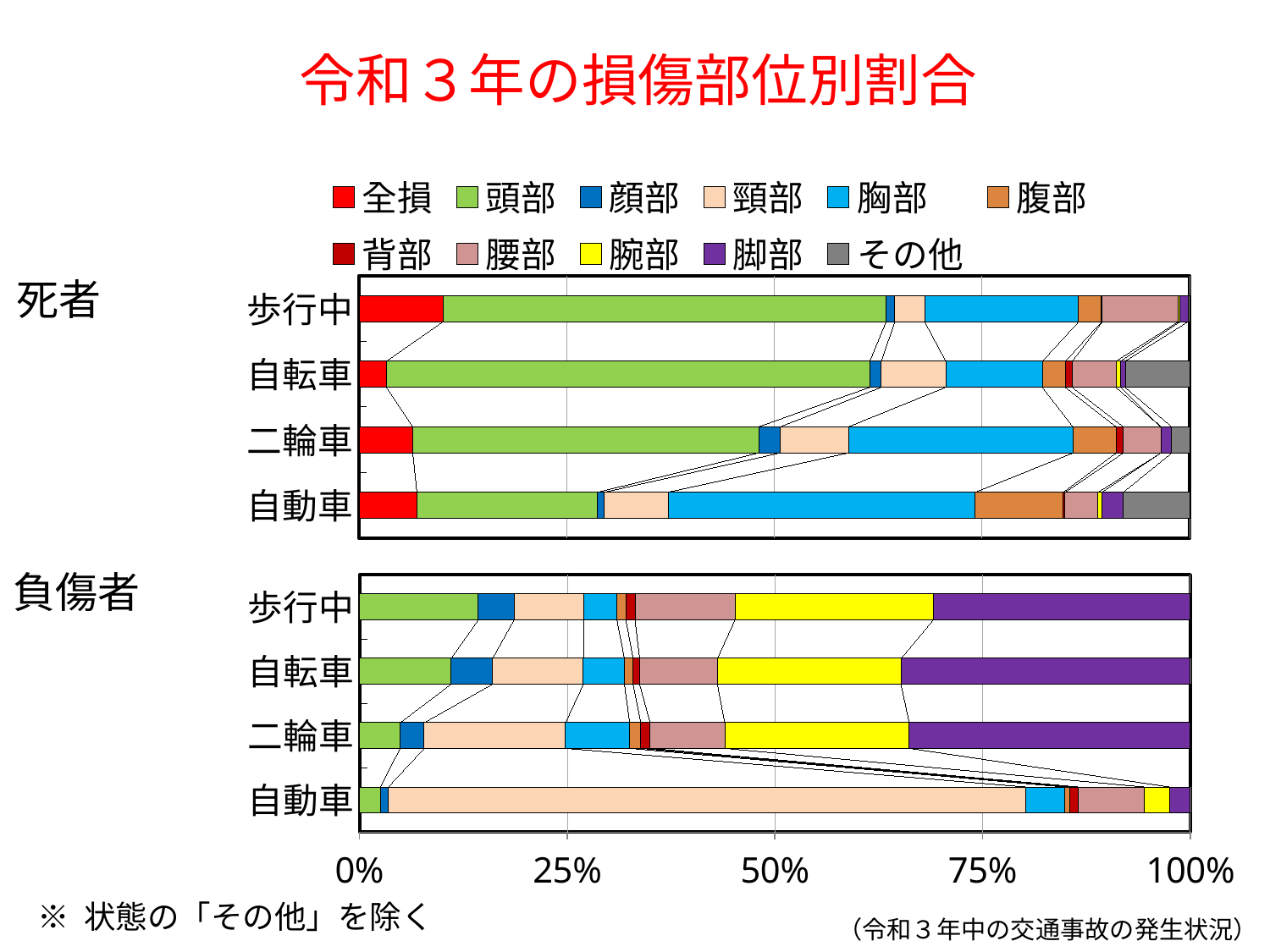
In the 負傷者 chart, is the 頸部 share for 自動車 greater or less than 50%? greater In the 死者 chart, how many categories are plotted? 4 In the 負傷者 chart, which category has the largest 頸部 share? 自動車 In the 負傷者 chart, is the 脚部 share for 自動車 greater or less than 25%? less What kind of chart is used on this slide? Stacked bar chart In the 負傷者 chart, which category has the smallest 脚部 share? 自動車 In the 負傷者 chart, how many categories are plotted? 4 In the 死者 chart, which has the larger 頭部 share, 歩行中 or 自動車? 歩行中 In the 死者 chart, is the 胸部 share for 自動車 greater or less than 25%? greater What is the title of the slide's chart? 令和３年の損傷部位別割合 Which legend entry is shown in yellow? 腕部 How many series does the legend list? 11